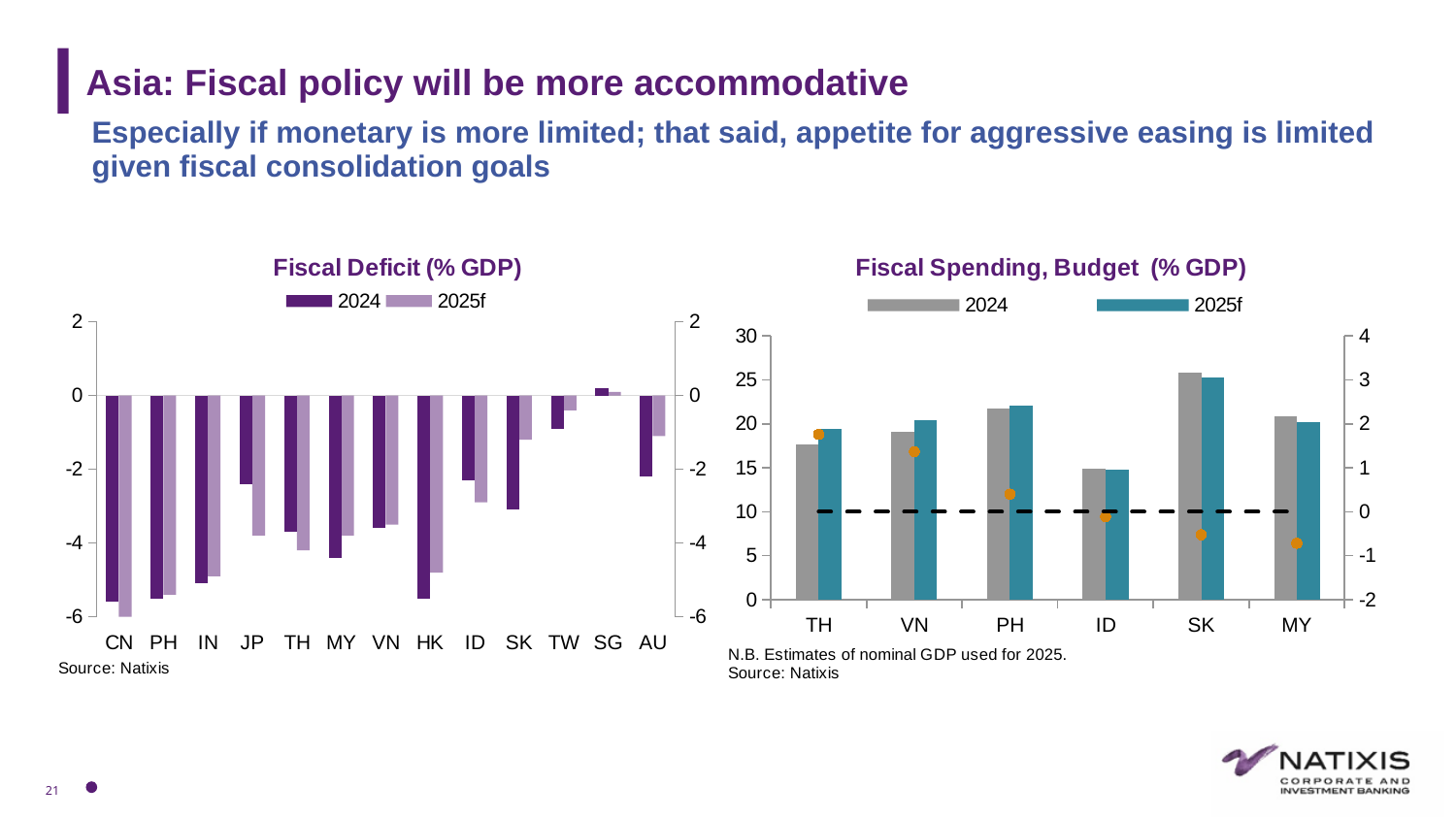
In the 'Fiscal Deficit (% GDP)' chart, which country has the lowest 2025f value? CN In the 'Fiscal Deficit (% GDP)' chart, which country has the highest 2024 value? SG In the 'Fiscal Spending, Budget (% GDP)' chart, which country has the lowest 2025f value? ID In the 'Fiscal Deficit (% GDP)' chart, is the 2024 value for HK greater or less than -4? less In the 'Fiscal Spending, Budget (% GDP)' chart, which country has the highest 2024 value? SK How many countries are shown on the x axis of the 'Fiscal Spending, Budget (% GDP)' chart? 6 How many series does the legend of the 'Fiscal Deficit (% GDP)' chart list? 2 How many series does the legend of the 'Fiscal Spending, Budget (% GDP)' chart list? 2 How many countries are shown on the x axis of the 'Fiscal Deficit (% GDP)' chart? 13 What kind of chart is the 'Fiscal Deficit (% GDP)' chart on the left? Bar chart In the 'Fiscal Spending, Budget (% GDP)' chart, is the 2024 value for PH greater or less than 20? greater In the 'Fiscal Deficit (% GDP)' chart, is the 2024 value for TW greater or less than -2? greater